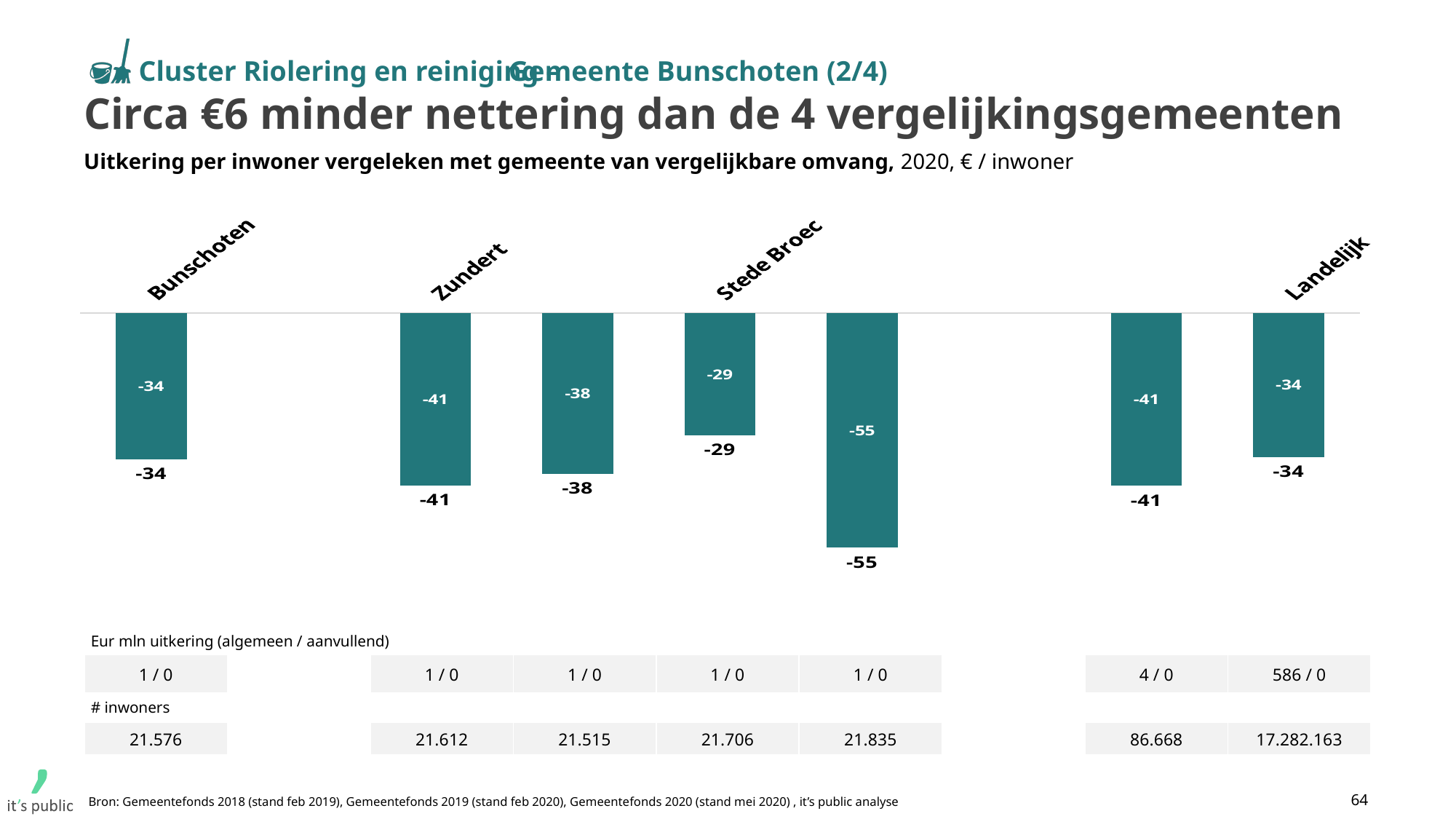
What is the value for Stede Broec? -29 Which is larger, the value for Stede Broec or the value for Landelijk? Stede Broec What kind of chart is shown on the slide? Bar chart Which is larger, the value for Bunschoten or the value for Zundert? Bunschoten What is the difference between the values for Stede Broec and Zundert? 12 How many bars are plotted in the chart? 7 What is the difference between the values for Bunschoten and Zundert? 7 What is the value for Zundert? -41 What is the value for Bunschoten? -34 What unit is stated in the chart subtitle? € / inwoner What is the value for Landelijk? -34 Which category has the highest (least negative) value? Stede Broec